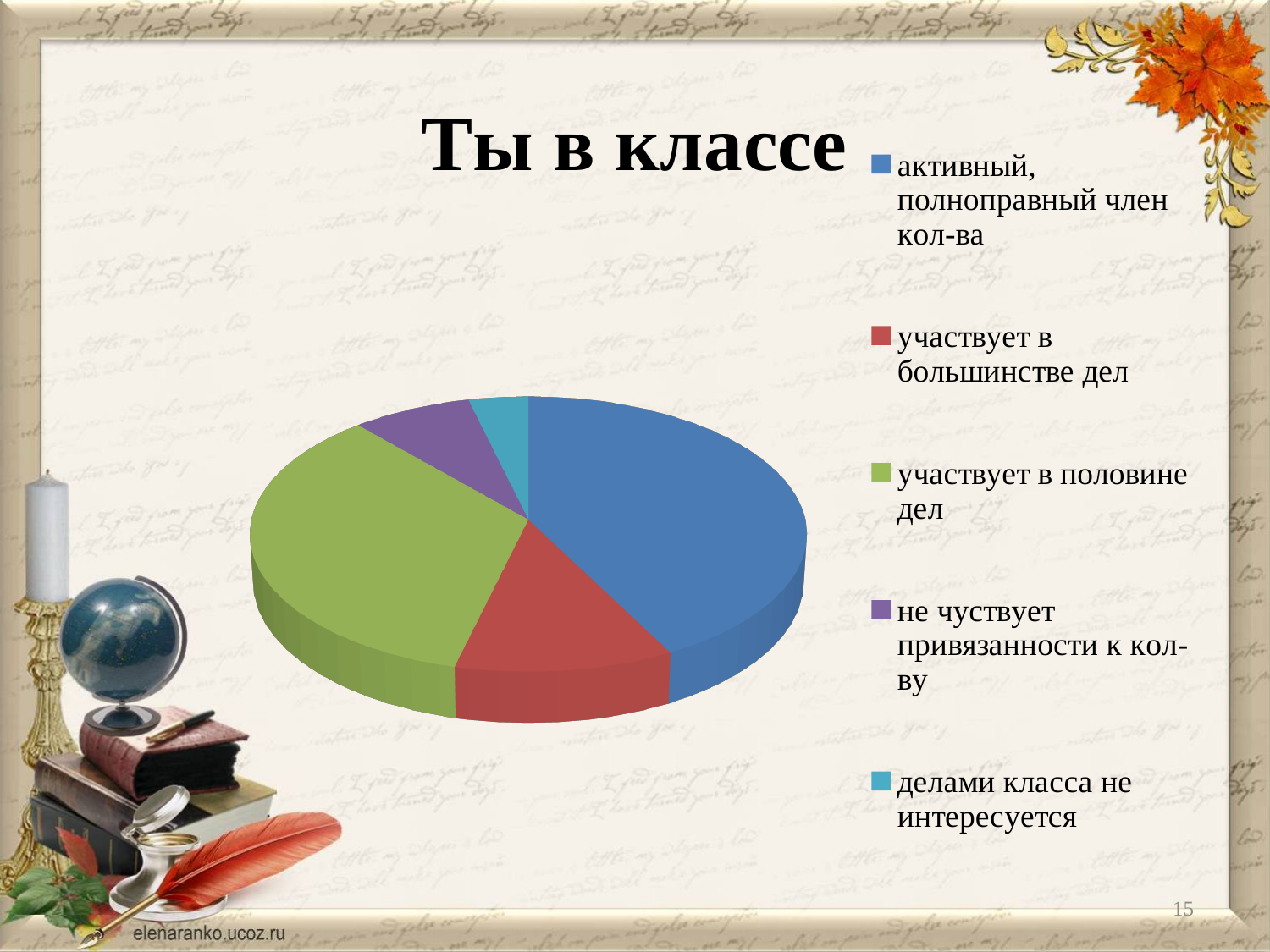
Which slice is larger: "активный, полноправный член кол-ва" or "участвует в большинстве дел"? активный, полноправный член кол-ва How many slices does the pie chart have? 5 What is the title of the chart? Ты в классе Which category has the largest slice of the pie? активный, полноправный член кол-ва What kind of chart is shown on the slide? pie chart Which slice is larger: "не чуствует привязанности к кол-ву" or "делами класса не интересуется"? не чуствует привязанности к кол-ву What colour is the slice for "участвует в половине дел"? green Which slice is larger: "участвует в большинстве дел" or "участвует в половине дел"? участвует в половине дел Which category has the smallest slice of the pie? делами класса не интересуется How many entries does the legend list? 5